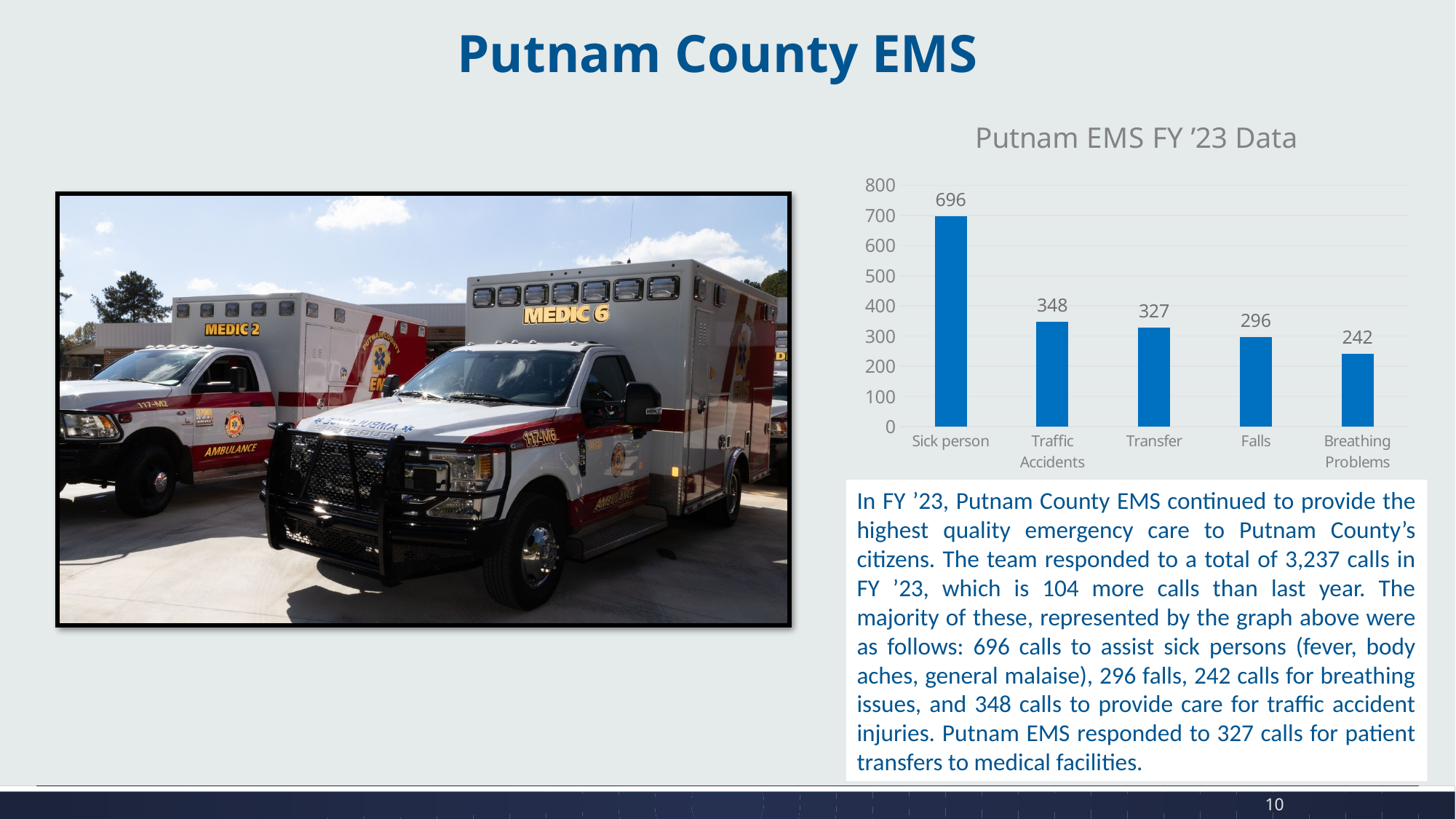
What is the title of the chart? Putnam EMS FY '23 Data What is the value for Breathing Problems in the chart? 242 What is the value for Traffic Accidents in the chart? 348 What kind of chart is shown on the slide? bar chart What is the difference between the values for Traffic Accidents and Transfer? 21 What is the difference between the values for Sick person and Falls? 400 Which category has the lowest value in the chart? Breathing Problems How many categories are shown in the chart? 5 What is the value for Sick person in the chart? 696 Which category has the highest value in the chart? Sick person Which is larger, the value for Transfer or the value for Falls? Transfer Is the value for Falls greater or less than 300? less